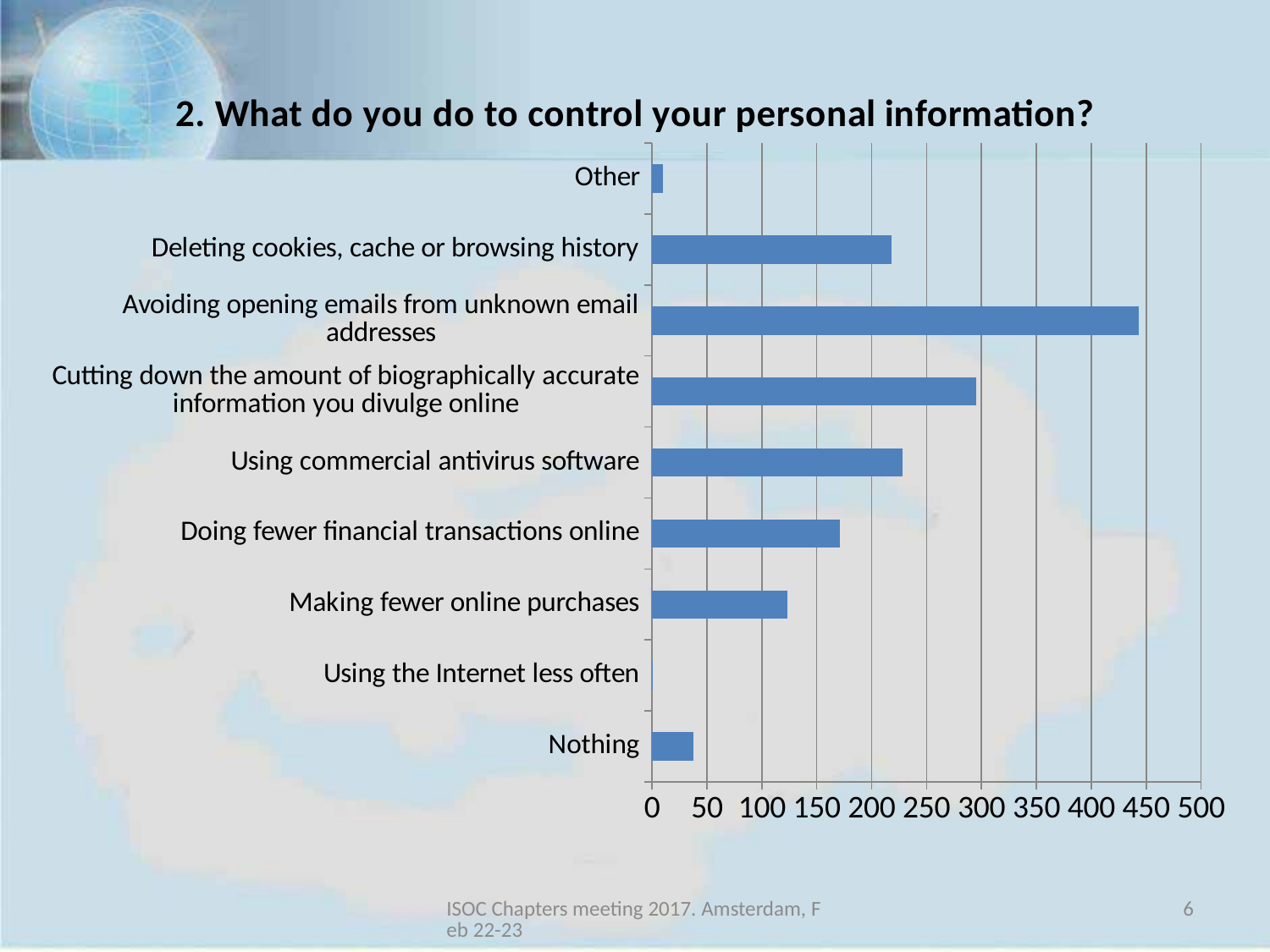
Is the value for 'Cutting down the amount of biographically accurate information you divulge online' greater or less than 250? greater Is the value for 'Nothing' greater or less than 50? less Which category has the highest value? Avoiding opening emails from unknown email addresses What is the title of the chart? 2. What do you do to control your personal information? Which category has the lowest value? Using the Internet less often How many categories are shown in the chart? 9 Is the value for 'Making fewer online purchases' greater or less than 100? greater What kind of chart is shown on the slide? bar chart Which is larger: the value for 'Cutting down the amount of biographically accurate information you divulge online' or for 'Deleting cookies, cache or browsing history'? Cutting down the amount of biographically accurate information you divulge online Which is larger: the value for 'Doing fewer financial transactions online' or for 'Making fewer online purchases'? Doing fewer financial transactions online